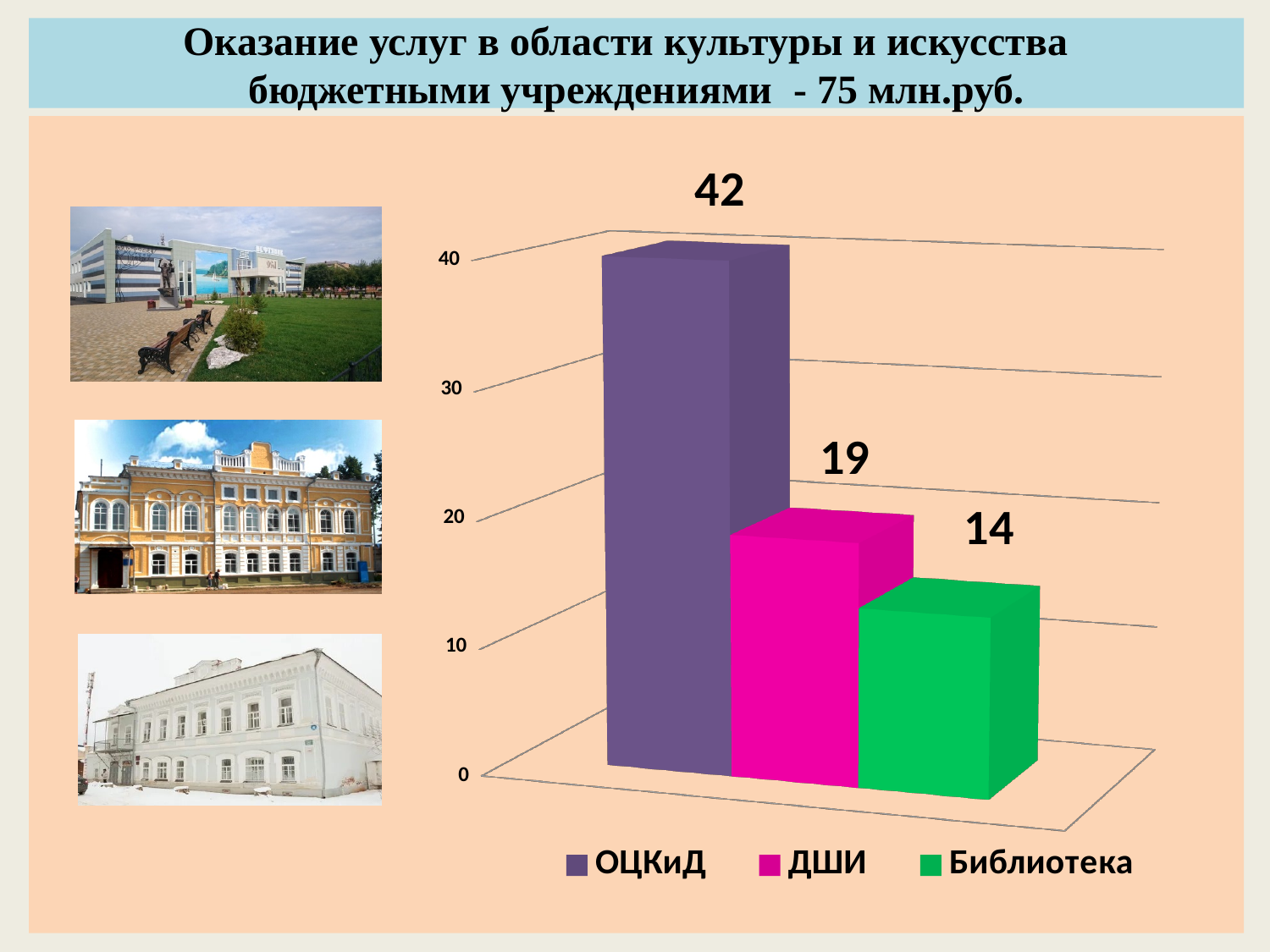
Is the value for ОЦКиД greater or less than 30? greater How many categories are shown in the chart? 3 Which category has the lowest value? Библиотека What is the value for ОЦКиД? 42 What colour is the bar for Библиотека? green Which is larger, the value for ДШИ or the value for Библиотека? ДШИ What kind of chart is shown on the slide? bar chart What is the value for ДШИ? 19 Which category has the highest value? ОЦКиД What is the difference between the values for ДШИ and Библиотека? 5 What is the difference between the values for ОЦКиД and ДШИ? 23 What is the value for Библиотека? 14